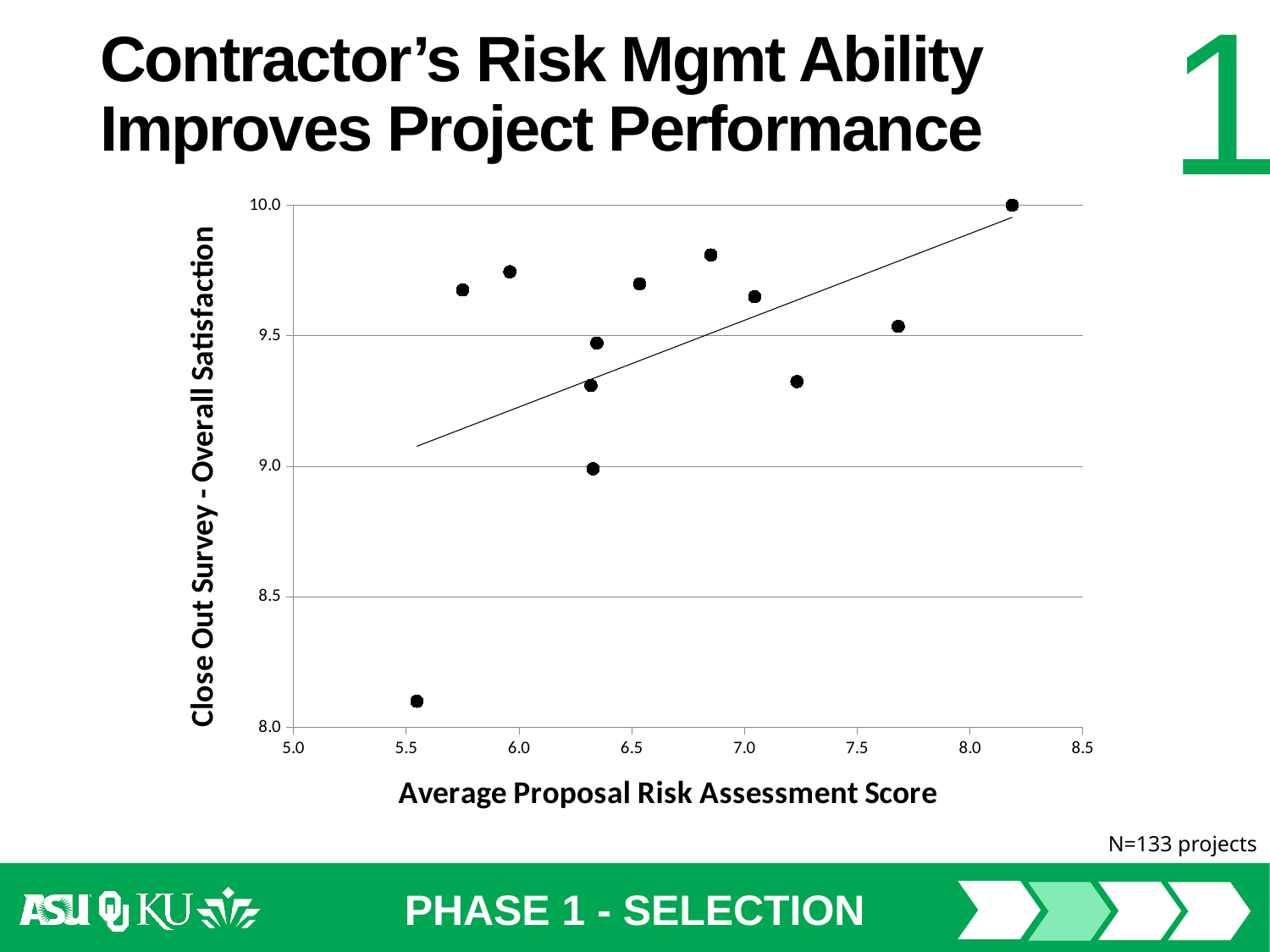
Does the trend line on the chart rise or fall as the Average Proposal Risk Assessment Score increases? Rises Is the Overall Satisfaction value of the point at a risk assessment score of about 7.2 greater or less than 9.5? less What is the highest value shown on the y axis? 10.0 Is the Overall Satisfaction value of the point with the highest risk assessment score greater or less than 9.5? greater Is the Overall Satisfaction value of the lowest point on the chart greater or less than 8.5? less What is the title of the y axis? Close Out Survey - Overall Satisfaction What kind of chart is shown on the slide? Scatter plot What is the lowest value shown on the x axis? 5.0 What is the highest Close Out Survey - Overall Satisfaction value reached by any point on the chart? 10.0 How many data points are plotted on the chart? 12 Which has the higher Overall Satisfaction: the point at a risk assessment score of about 5.5 or the point at about 8.2? The point at about 8.2